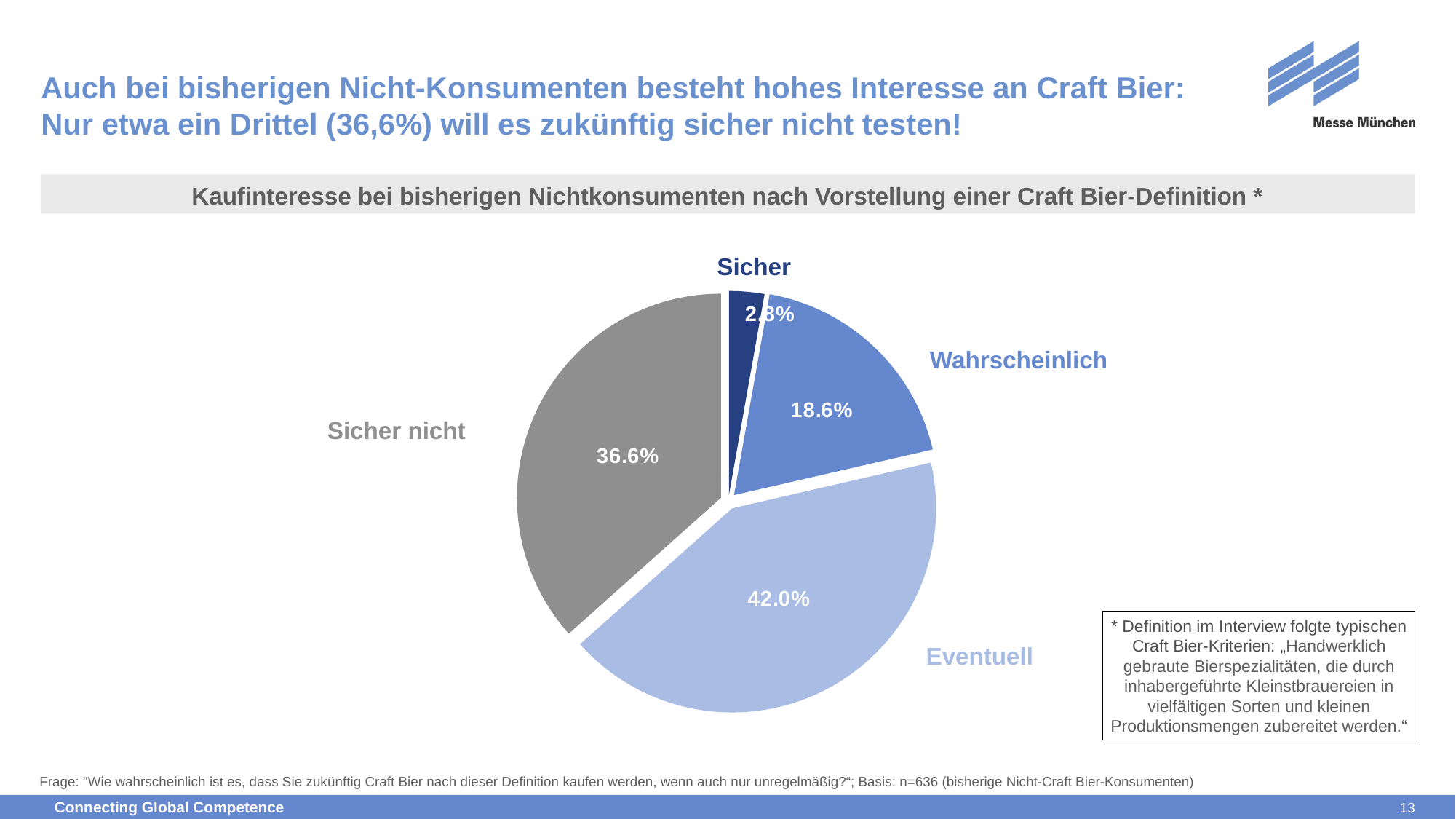
What is the difference between the "Eventuell" and "Sicher nicht" values? 5.4% What kind of chart is shown on the slide? pie chart How many slices does the pie chart have? 4 What is the title of the chart? Kaufinteresse bei bisherigen Nichtkonsumenten nach Vorstellung einer Craft Bier-Definition * Which category has the largest slice of the pie? Eventuell Which category has the smallest slice of the pie? Sicher What is the value shown for "Sicher"? 2.8% What is the value shown for "Wahrscheinlich"? 18.6% Which is larger, the value for "Wahrscheinlich" or the value for "Sicher nicht"? Sicher nicht What is the value shown for "Sicher nicht"? 36.6% What is the combined share of "Sicher" and "Wahrscheinlich"? 21.4% What share of the pie does the "Eventuell" slice represent? 42.0%